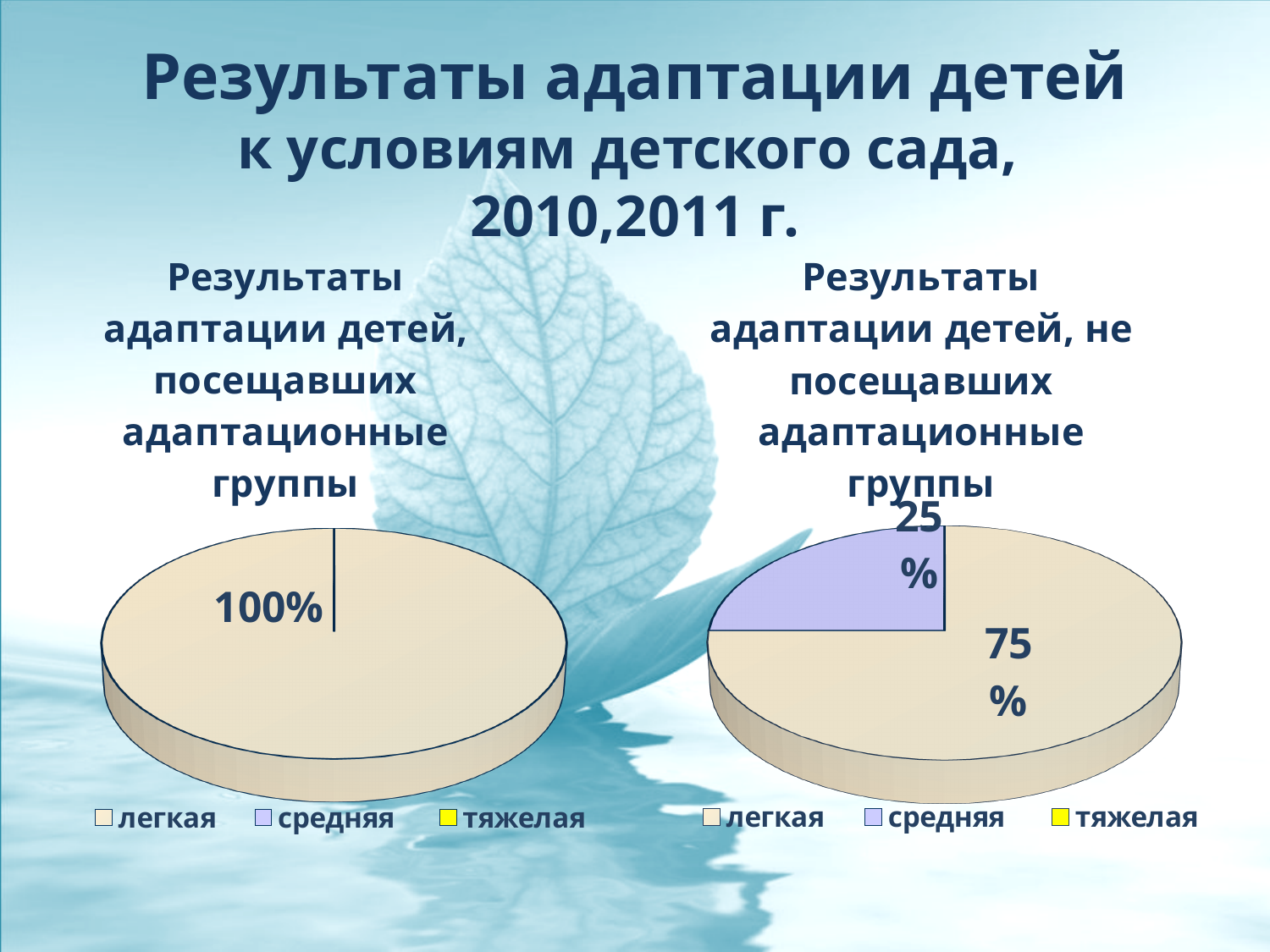
In the right chart (children who did not attend adaptation groups), which is larger, the 'легкая' slice or the 'средняя' slice? легкая In the left chart (children who attended adaptation groups), what share is labelled for the 'легкая' slice? 100% Which categories are listed in the legend of the right chart? легкая, средняя, тяжелая In the right chart (children who did not attend adaptation groups), what share is labelled for the 'легкая' slice? 75% In the right chart (children who did not attend adaptation groups), what is the difference between the 'легкая' and 'средняя' shares? 50% In the right chart (children who did not attend adaptation groups), which category has the largest slice? легкая Which chart shows a 'легкая' share of 100%? the left chart (Результаты адаптации детей, посещавших адаптационные группы) In the right chart (children who did not attend adaptation groups), what share is labelled for the 'средняя' slice? 25% What is the title of the right chart? Результаты адаптации детей, не посещавших адаптационные группы How many entries does the legend of the left chart list? 3 Is the 'легкая' share in the right chart (children who did not attend adaptation groups) greater or less than 50%? greater What kind of chart is the left chart, 'Результаты адаптации детей, посещавших адаптационные группы'? pie chart